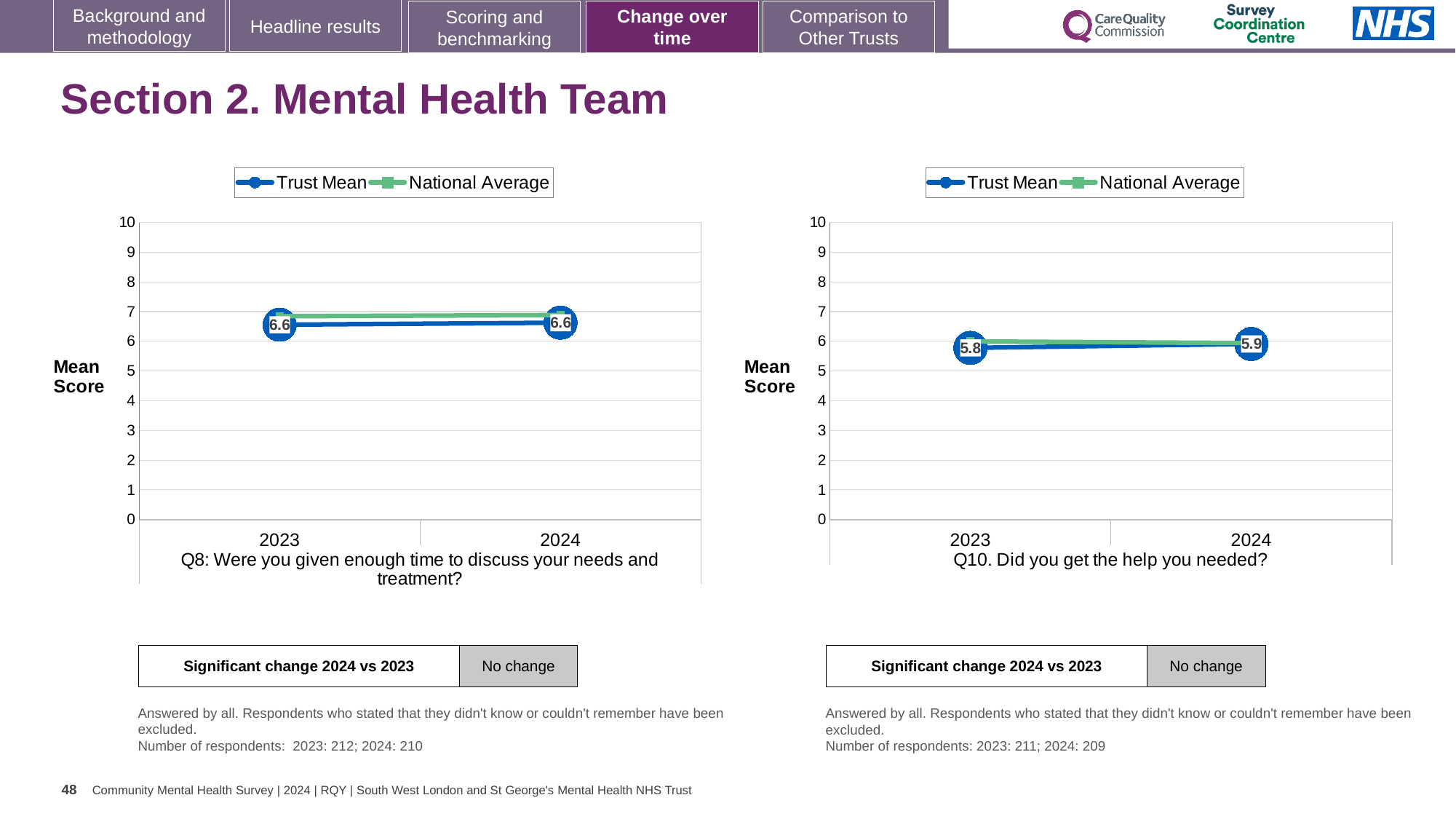
In the right chart (Q10), is the National Average for 2023 greater or less than 5? greater What kind of chart is the left chart (Q8)? Line chart In the left chart (Q8), does the Trust Mean rise, fall or stay the same from 2023 to 2024? Stays the same In the right chart (Q10), which year has the higher Trust Mean, 2023 or 2024? 2024 In the left chart (Q8), what is the Trust Mean for 2024? 6.6 How many series does the legend of the right chart (Q10) list? 2 In the right chart (Q10), what is the Trust Mean for 2023? 5.8 In the left chart (Q8), is the National Average for 2024 greater or less than 6? greater In the right chart (Q10), what is the difference between the Trust Mean for 2024 and 2023? 0.1 In the right chart (Q10), what is the Trust Mean for 2024? 5.9 In the left chart (Q8), what is the Trust Mean for 2023? 6.6 How many years are shown on the x axis of the left chart (Q8)? 2